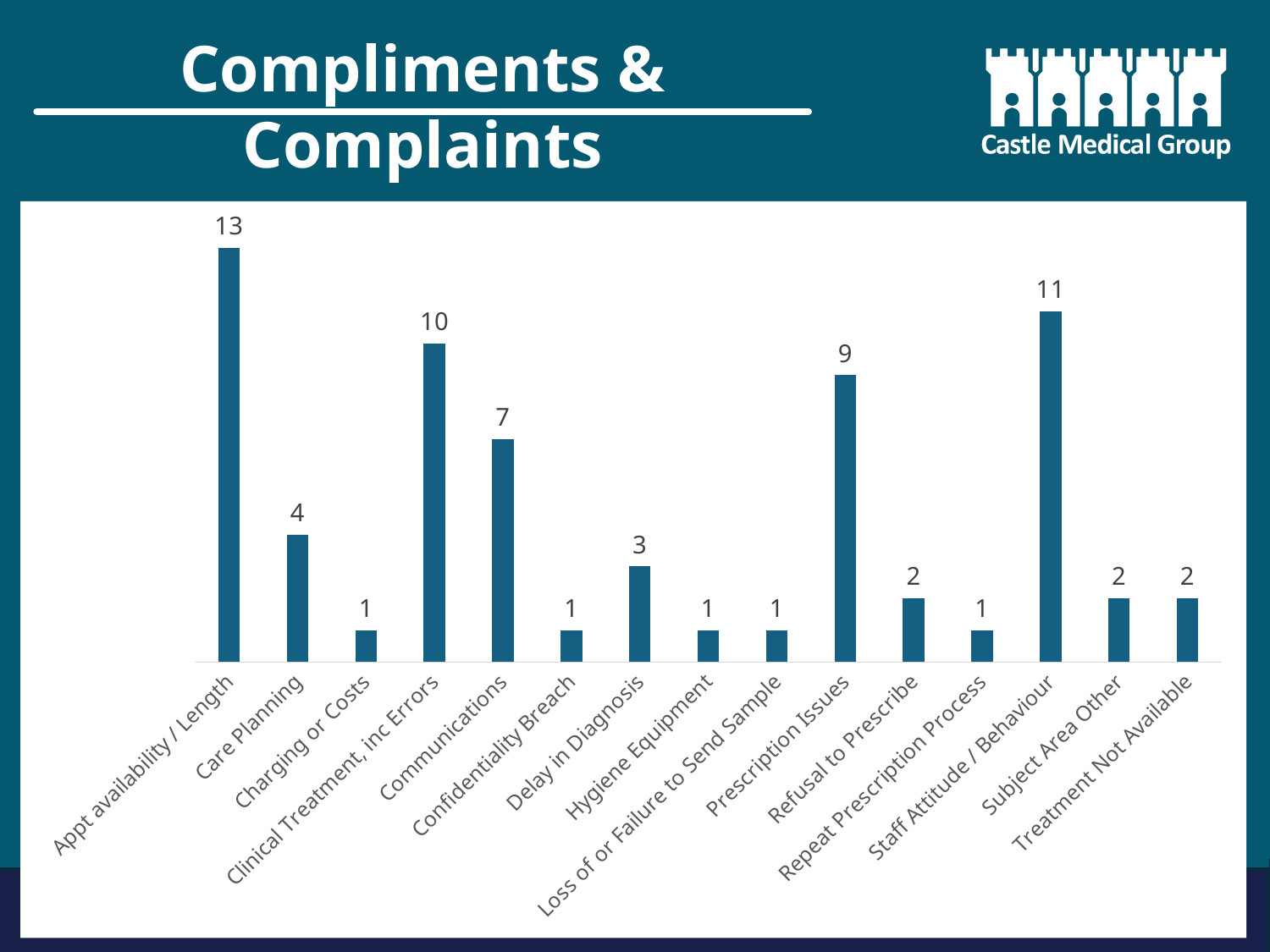
How many categories are shown on the x axis? 15 What is the value for Staff Attitude / Behaviour? 11 What kind of chart is shown on the slide? Bar chart Which category has the highest value? Appt availability / Length What is the title of the slide containing the chart? Compliments & Complaints What is the difference between the values for Appt availability / Length and Care Planning? 9 Which is larger, the value for Staff Attitude / Behaviour or the value for Clinical Treatment, inc Errors? Staff Attitude / Behaviour What is the value for Appt availability / Length? 13 What is the difference between the values for Clinical Treatment, inc Errors and Prescription Issues? 1 What is the value for Communications? 7 What is the value for Delay in Diagnosis? 3 Which is larger, the value for Care Planning or the value for Refusal to Prescribe? Care Planning